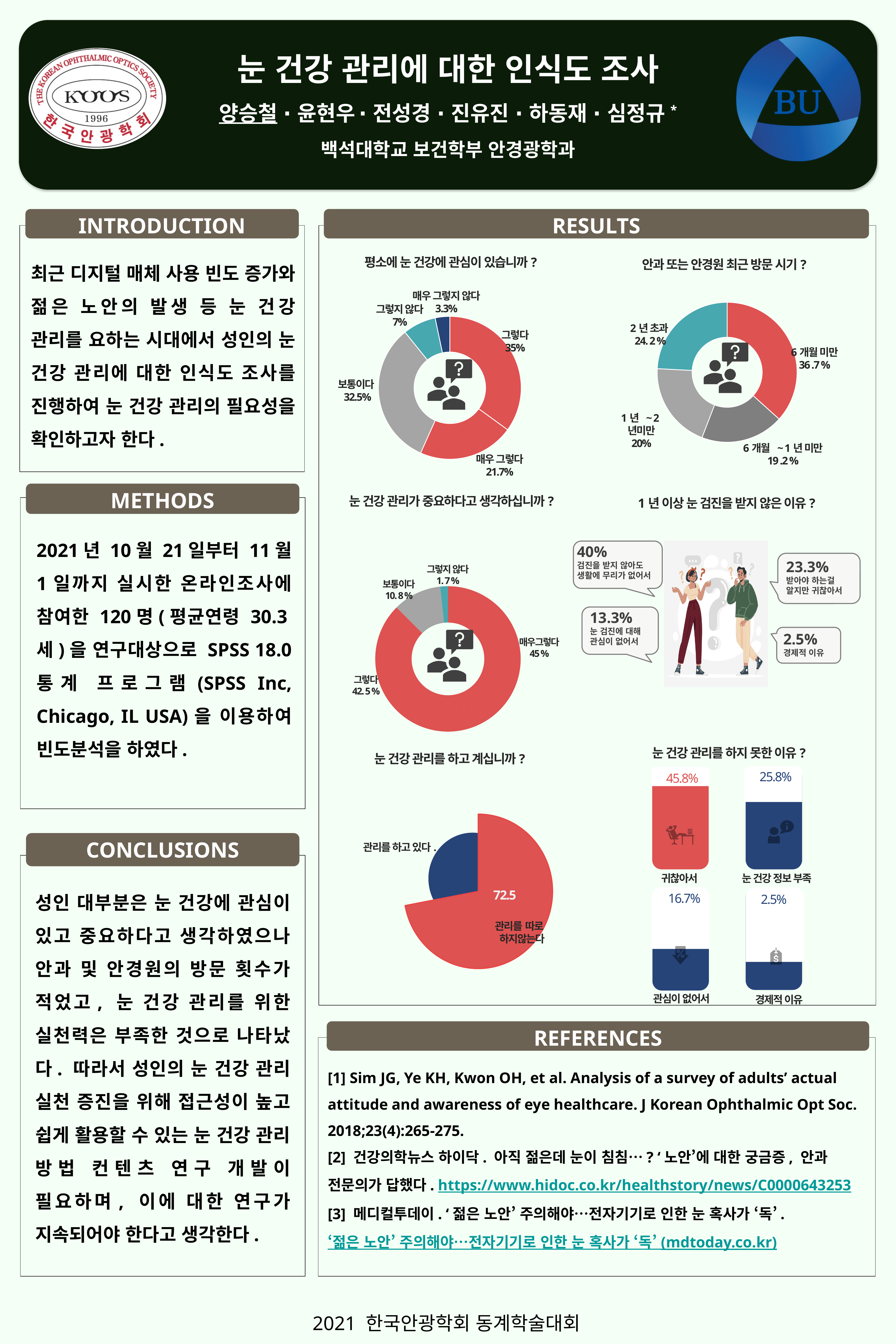
What kind of chart is used for '눈 건강 관리를 하고 계십니까?'? Pie chart In the chart titled '눈 건강 관리가 중요하다고 생각하십니까?', what percentage is shown for '매우 그렇다'? 45% In the chart titled '안과 또는 안경원 최근 방문 시기?', what percentage is shown for '2년 초과'? 24.2% In the chart titled '눈 건강 관리가 중요하다고 생각하십니까?', which is larger, '보통이다' or '그렇지 않다'? 보통이다 In the chart titled '눈 건강 관리를 하지 못한 이유?', which reason has the highest percentage? 귀찮아서 In the chart titled '평소에 눈 건강에 관심이 있습니까?', which category has the smallest share? 매우 그렇지 않다 In the chart titled '눈 건강 관리를 하지 못한 이유?', what percentage is shown for '눈 건강 정보 부족'? 25.8% In the chart titled '안과 또는 안경원 최근 방문 시기?', what is the difference between '6개월 미만' and '6개월~1년 미만'? 17.5% In the chart titled '평소에 눈 건강에 관심이 있습니까?', what percentage is shown for '보통이다'? 32.5% In the chart titled '평소에 눈 건강에 관심이 있습니까?', how many categories are shown? 5 In the chart titled '눈 건강 관리를 하고 계십니까?', what value is shown for '관리를 따로 하지않는다'? 72.5 In the chart titled '안과 또는 안경원 최근 방문 시기?', which category has the largest share? 6개월 미만